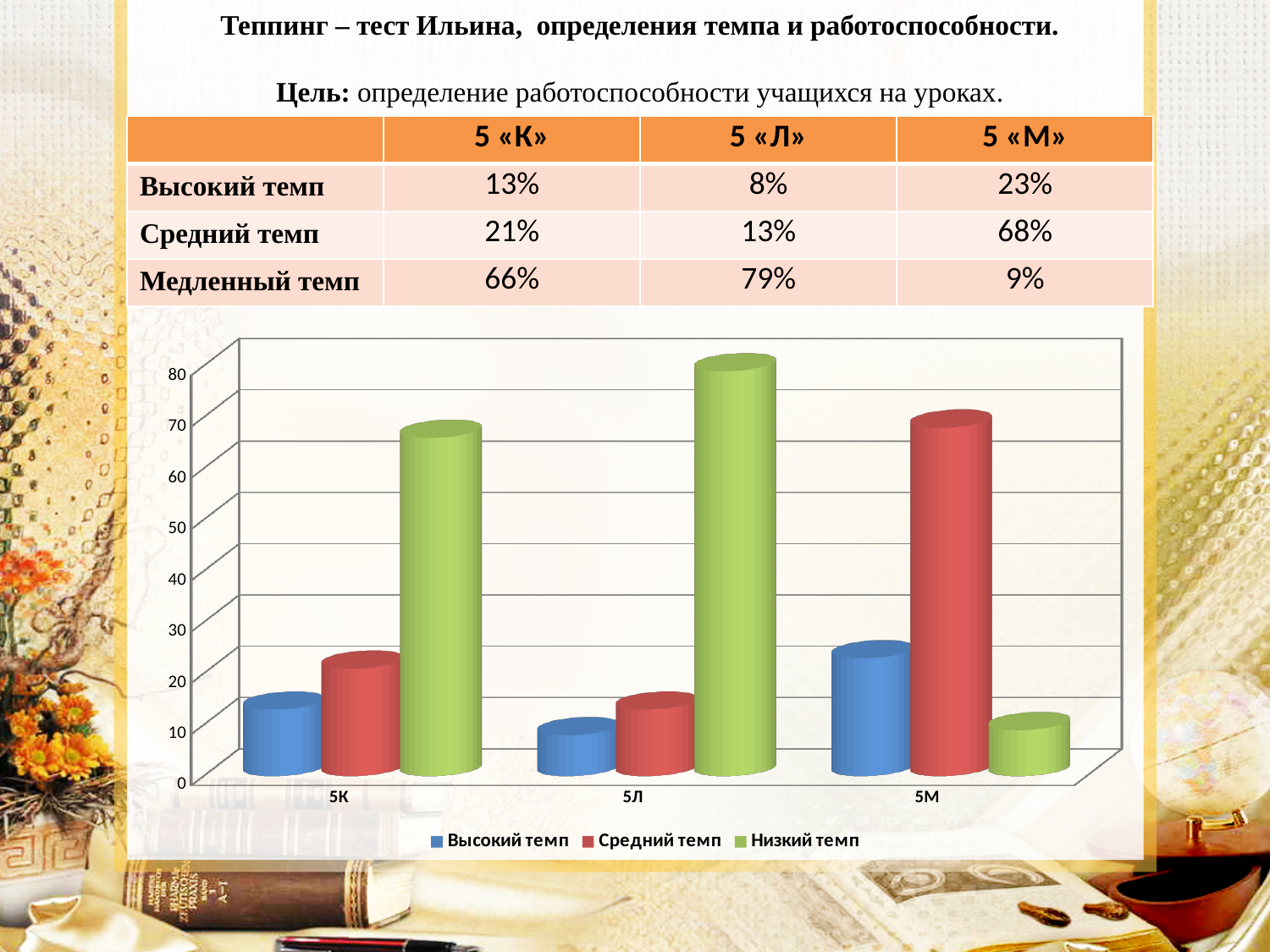
What is the difference between the Средний темп values for 5 «М» and 5 «К» shown on the slide? 47% Which category has the lowest value for the Высокий темп series? 5Л Which is larger in 5М: Средний темп or Низкий темп? Средний темп How many series does the chart legend list? 3 Which series is shown in green in the chart legend? Низкий темп According to the slide, what is the value for Медленный темп in 5 «Л»? 79% According to the slide, what is the value for Высокий темп in 5 «М»? 23% How many categories are shown on the x axis of the chart? 3 Which category has the highest value for the Низкий темп series? 5Л What kind of chart is shown on the slide? bar chart Is the value for Низкий темп in 5Л greater or less than 70? greater Is the value for Средний темп in 5К greater or less than 30? less